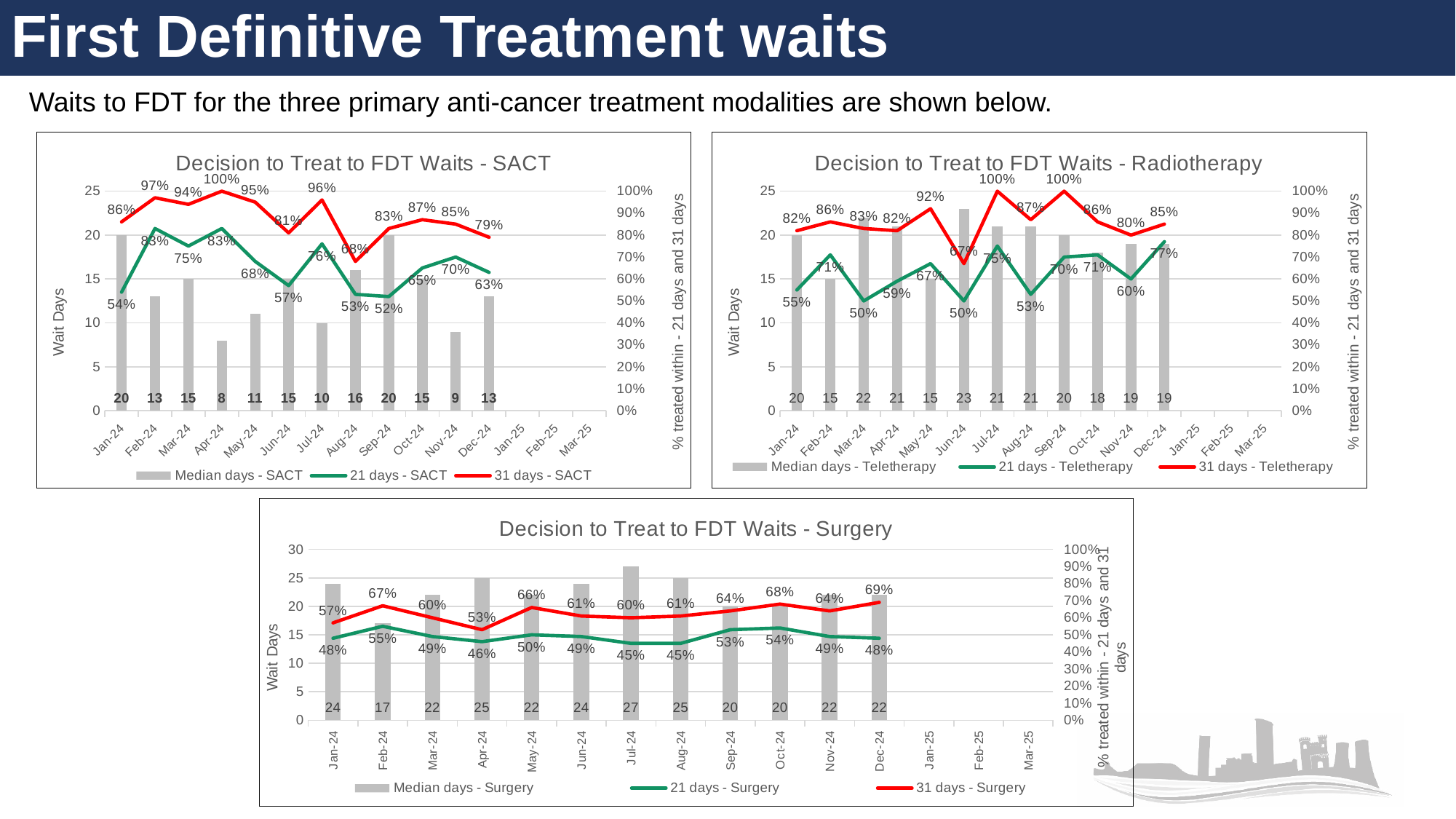
In the 'Decision to Treat to FDT Waits - Surgery' chart, what is the median days value for Jul-24? 27 How many series does the legend of the 'Decision to Treat to FDT Waits - Surgery' chart list? 3 In the 'Decision to Treat to FDT Waits - Radiotherapy' chart, what percentage was treated within 21 days in Dec-24? 77% In the 'Decision to Treat to FDT Waits - Radiotherapy' chart, what is the difference between the 31 days and 21 days percentages in Jun-24? 17% In the 'Decision to Treat to FDT Waits - SACT' chart, what is the median days value for Apr-24? 8 In the 'Decision to Treat to FDT Waits - Surgery' chart, is the 31 days percentage higher in Dec-24 or Apr-24? Dec-24 In the 'Decision to Treat to FDT Waits - SACT' chart, how many months have a median days bar plotted? 12 In the 'Decision to Treat to FDT Waits - Surgery' chart, which month has the lowest median days? Feb-24 In the 'Decision to Treat to FDT Waits - Radiotherapy' chart, which month has the highest median days? Jun-24 In the 'Decision to Treat to FDT Waits - Radiotherapy' chart, what colour is the '31 days - Teletherapy' line? Red In the 'Decision to Treat to FDT Waits - SACT' chart, which month has the lowest median days? Apr-24 In the 'Decision to Treat to FDT Waits - SACT' chart, what percentage was treated within 31 days in Feb-24? 97%